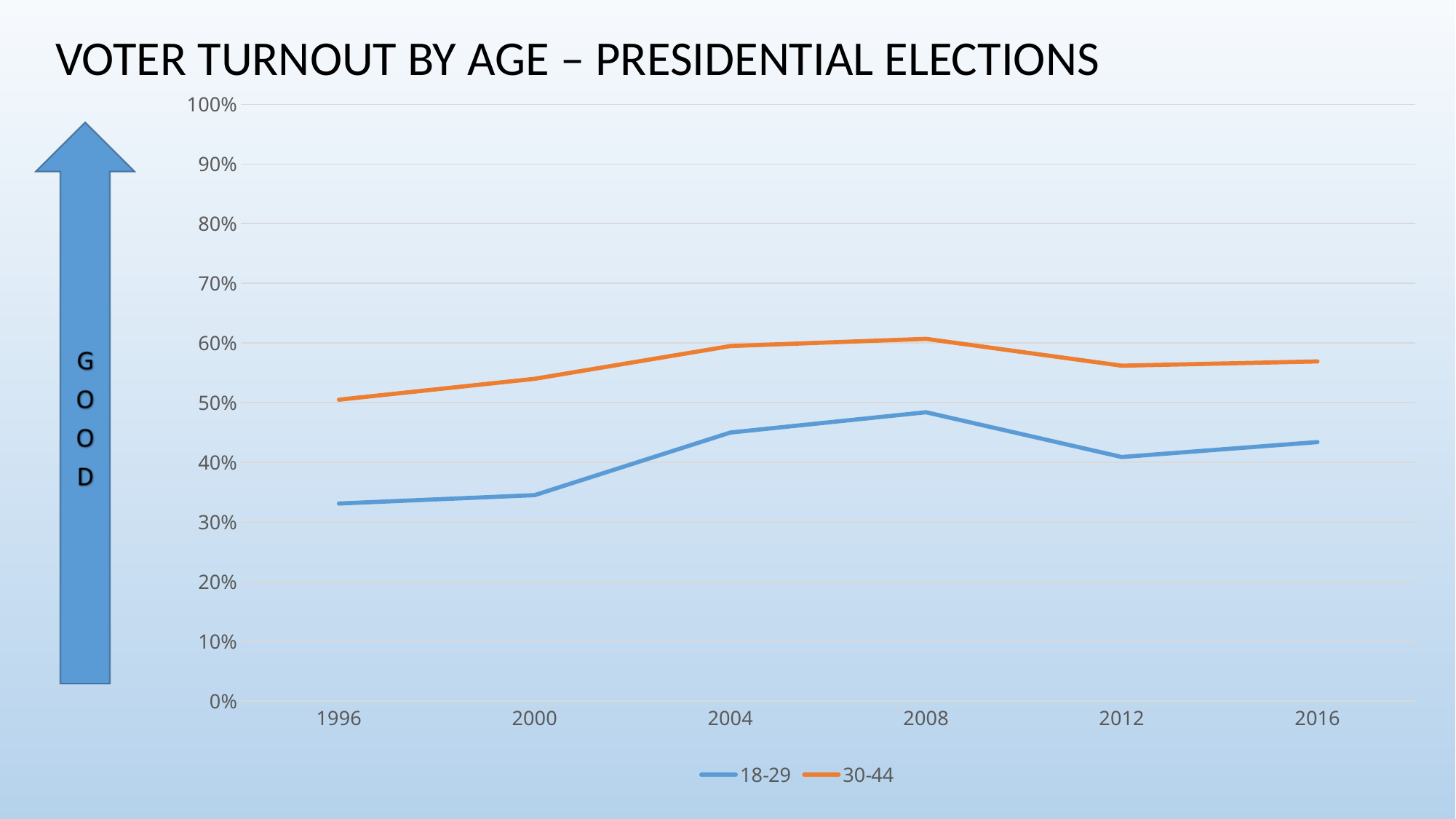
In which year does the 30-44 series have its lowest value? 1996 How many series does the legend list? 2 Is the value for 18-29 in 2008 greater or less than 50%? less Is the value for 30-44 in 2012 greater or less than 60%? less In which year does the 18-29 series reach its highest value? 2008 What is the title of the chart? VOTER TURNOUT BY AGE – PRESIDENTIAL ELECTIONS Which series has the higher value in 2016, 18-29 or 30-44? 30-44 Does the 18-29 series rise or fall from 1996 to 2008? rise What kind of chart is shown on the slide? line chart How many election years are plotted on the x axis? 6 Is the value for 18-29 in 1996 greater or less than 40%? less